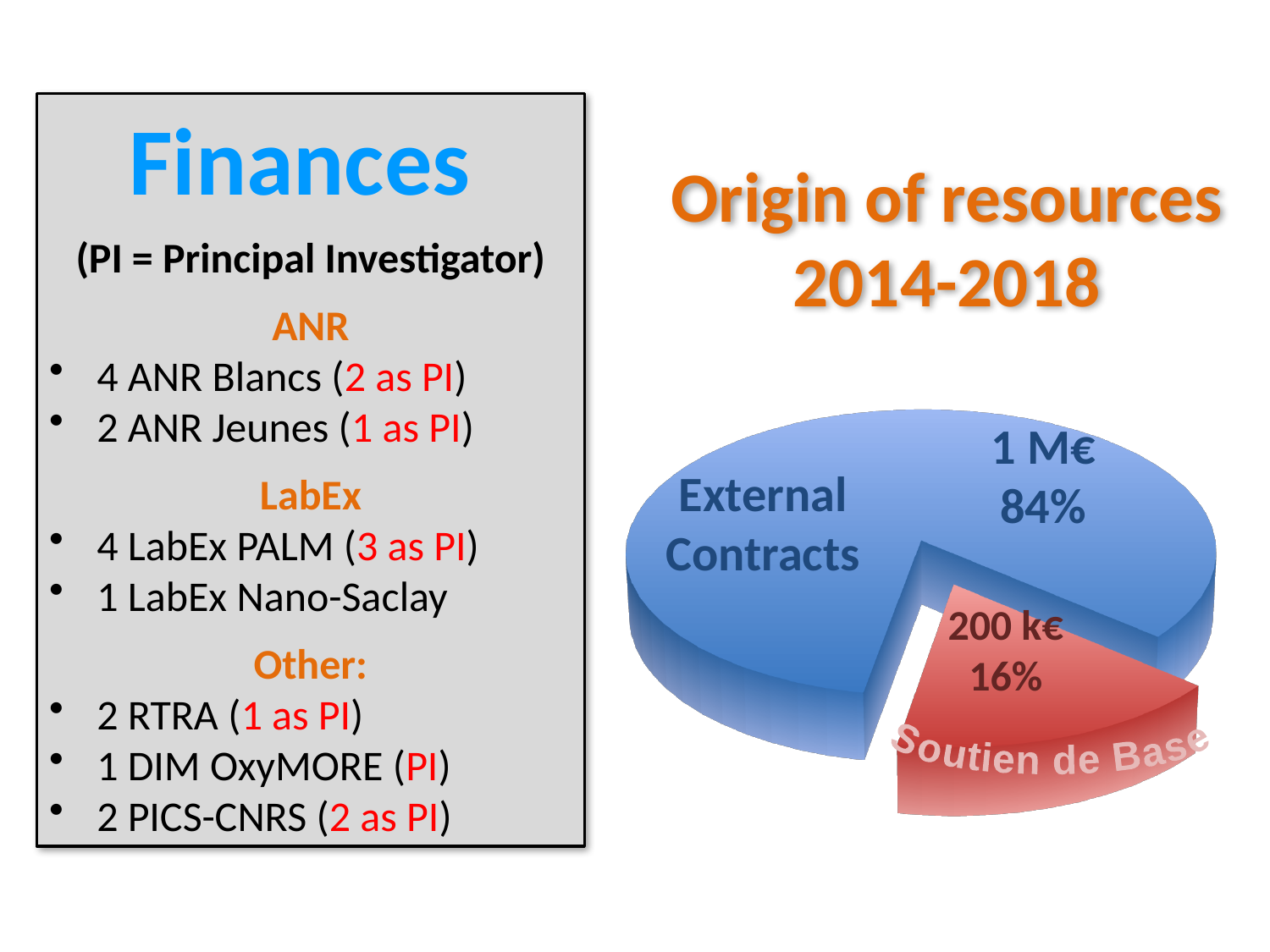
What kind of chart is shown on the slide? pie chart Which slice is the largest? External Contracts What colour is the Soutien de Base slice? red Which slice is the smallest? Soutien de Base What is the value shown for External Contracts? 1 M€ Which is larger, External Contracts or Soutien de Base? External Contracts What share of the pie is Soutien de Base? 16% How many slices does the pie chart have? 2 What share of the pie is External Contracts? 84% What is the difference in percentage points between the External Contracts share and the Soutien de Base share? 68 What is the title of the chart? Origin of resources 2014-2018 What is the value shown for Soutien de Base? 200 k€